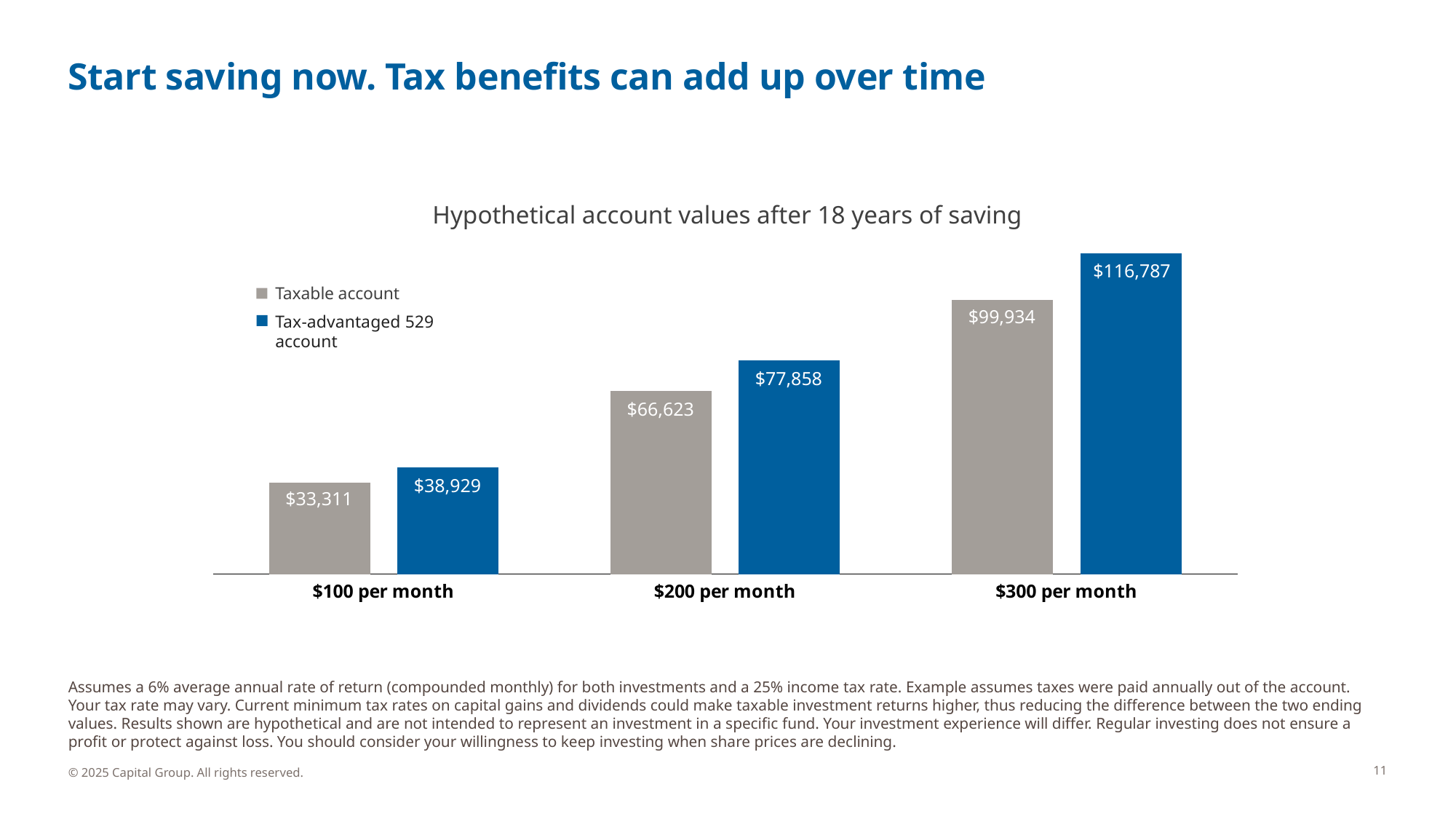
How many series does the legend list? 2 What is the value of the Tax-advantaged 529 account bar for $200 per month? $77,858 How many monthly contribution categories are shown on the x axis? 3 What is the difference between the Tax-advantaged 529 account and the Taxable account at $300 per month? $16,853 What is the difference between the Tax-advantaged 529 account and the Taxable account at $100 per month? $5,618 What is the value of the Taxable account bar for $100 per month? $33,311 What is the value of the Tax-advantaged 529 account bar for $300 per month? $116,787 Which bar in the chart has the highest value? Tax-advantaged 529 account, $300 per month Which is larger at $200 per month: the Taxable account or the Tax-advantaged 529 account? Tax-advantaged 529 account What is the title of the chart? Hypothetical account values after 18 years of saving What kind of chart is shown on the slide? Bar chart Which bar in the chart has the lowest value? Taxable account, $100 per month